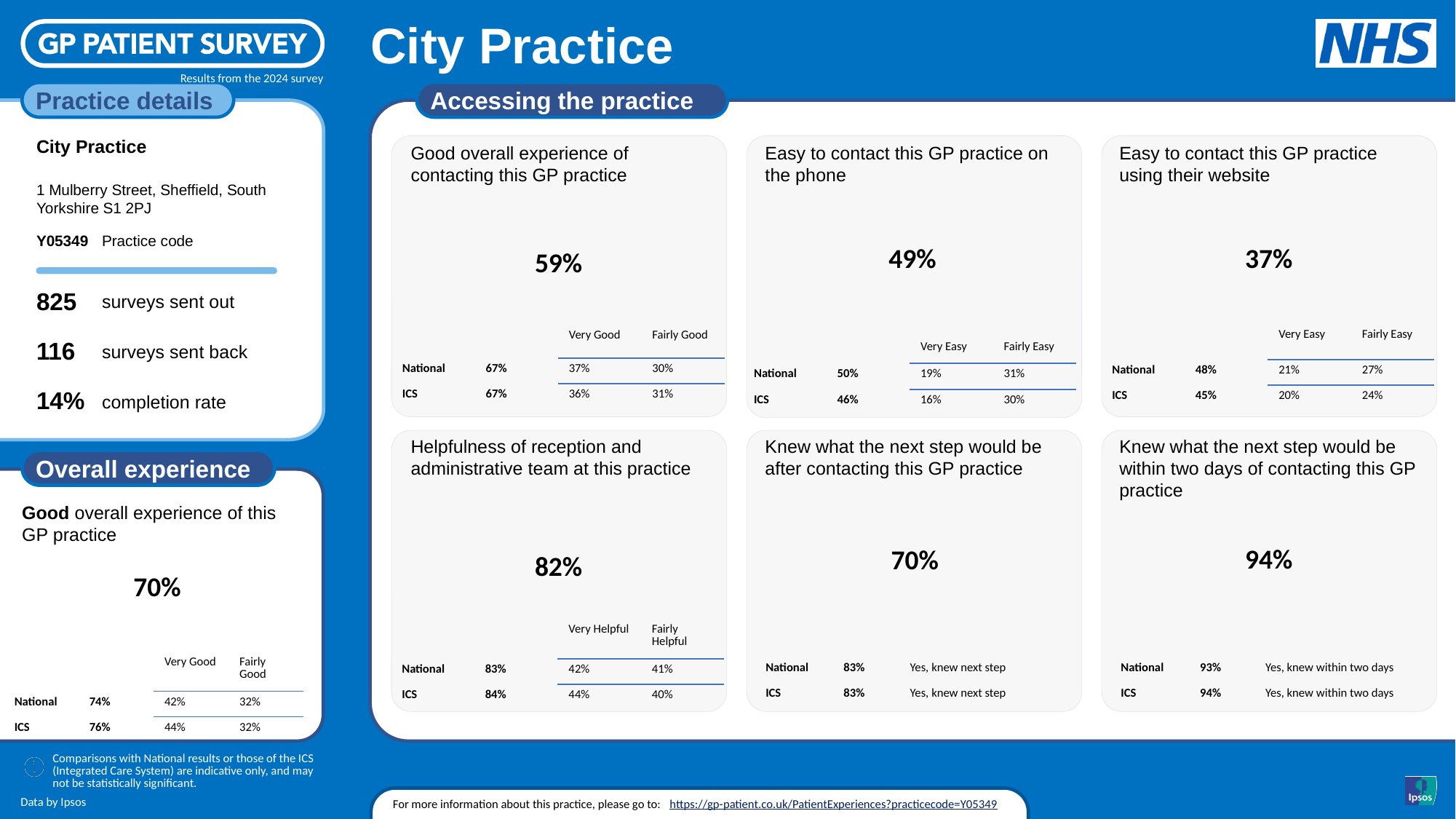
Among the six 'Accessing the practice' panels, which has the highest headline value? Knew what the next step would be within two days of contacting this GP practice In the 'Helpfulness of reception and administrative team at this practice' panel, what is the National value for Fairly Helpful? 41% How many panels are shown under the 'Accessing the practice' heading? 6 In the 'Easy to contact this GP practice using their website' panel, what is the ICS value for Very Easy? 20% In the 'Easy to contact this GP practice on the phone' panel, what is the National value? 50% In the 'Easy to contact this GP practice on the phone' panel, what is the difference between the National value (50%) and the ICS value (46%)? 4% In the 'Knew what the next step would be within two days of contacting this GP practice' panel, what is the practice's headline value? 94% In the 'Knew what the next step would be after contacting this GP practice' panel, which is larger: the practice's headline value (70%) or the ICS value (83%)? ICS In the 'Good overall experience of this GP practice' panel, what is the ICS value for Very Good? 44% In the 'Good overall experience of contacting this GP practice' panel, which is larger: the practice's headline value or the National value? National Among the six 'Accessing the practice' panels, which has the lowest headline value? Easy to contact this GP practice using their website In the 'Good overall experience of contacting this GP practice' panel, what is the practice's headline value? 59%